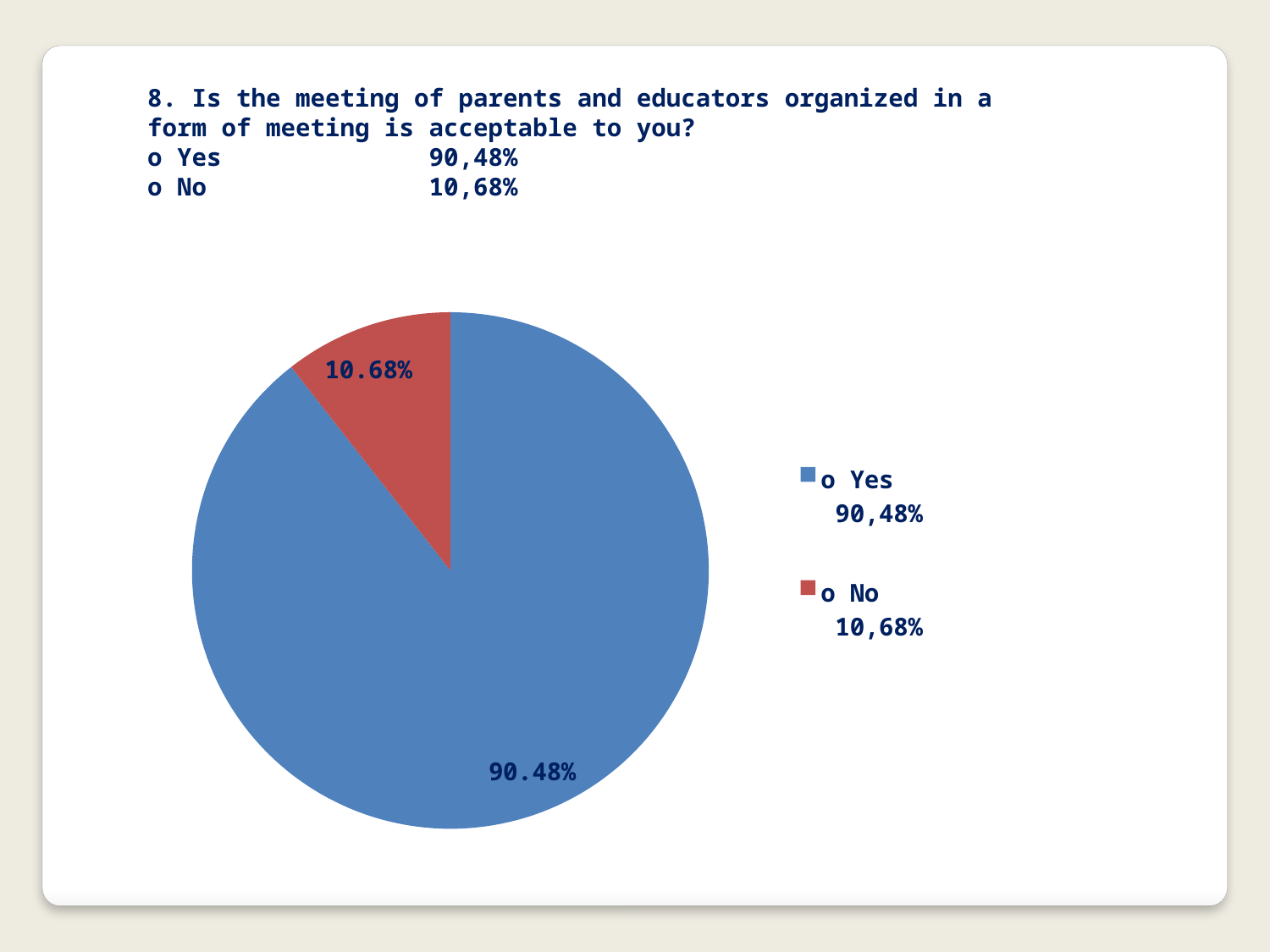
What colour is the "o No" slice in the pie chart? red How many slices does the pie chart have? 2 Which slice of the pie chart is the largest? o Yes What colour is the "o Yes" slice in the pie chart? blue What percentage of the pie is labelled for the "o Yes" slice? 90.48% What kind of chart is shown on the slide? pie chart How many entries does the legend list? 2 What share of the pie does the "o No" slice represent? 10.68% What percentage of the pie is labelled for the "o No" slice? 10.68% By how many percentage points does the "o Yes" slice exceed the "o No" slice? 79.80 percentage points Which is larger, the "o Yes" slice or the "o No" slice? o Yes Which slice of the pie chart is the smallest? o No